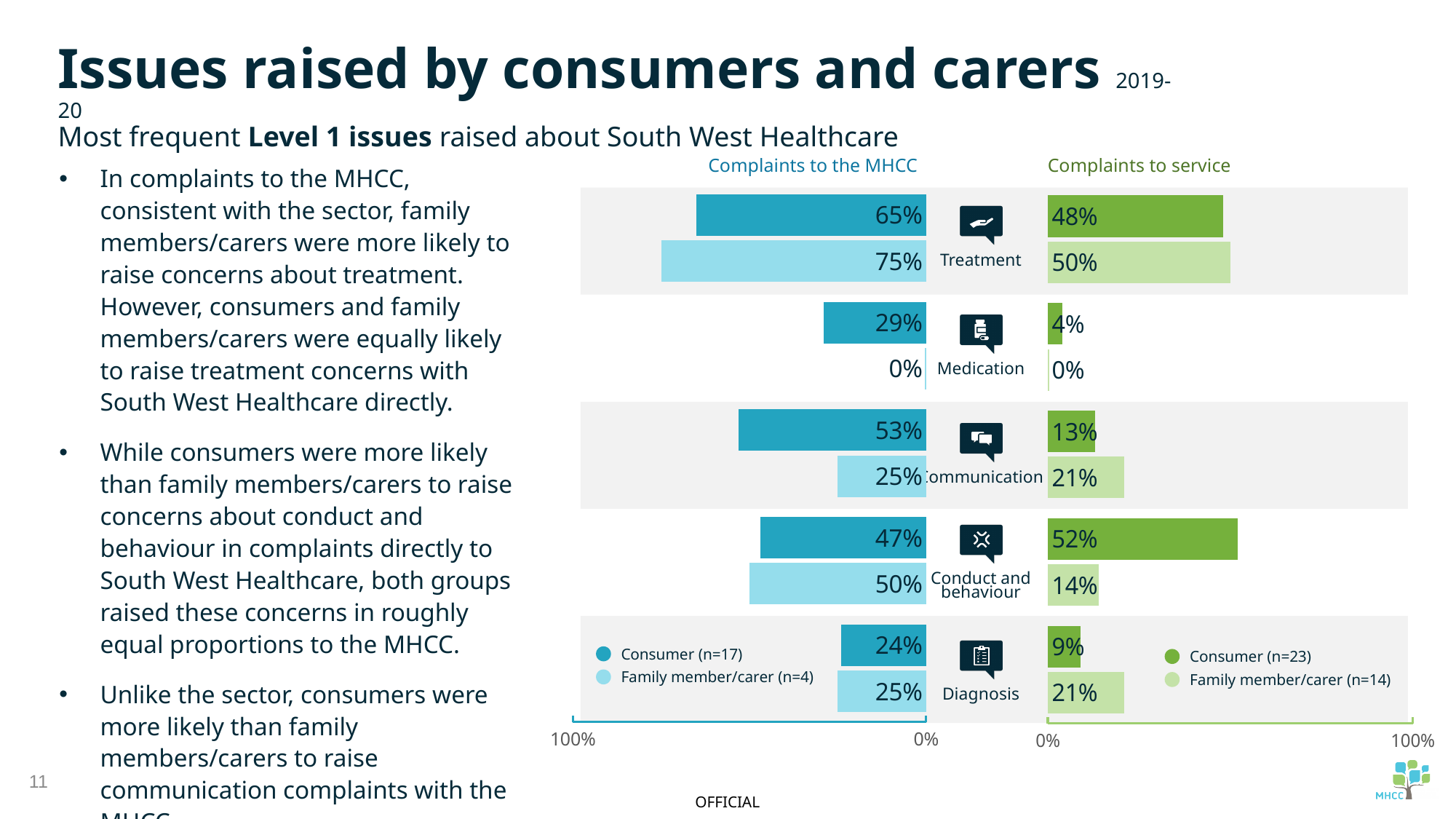
In the 'Complaints to the MHCC' chart, what is the value for Consumer for Treatment? 65% In the 'Complaints to service' chart, which category has the lowest Consumer value? Medication In the 'Complaints to service' chart, what is the value for Consumer for Conduct and behaviour? 52% In the 'Complaints to service' chart, what is the value for Family member/carer for Diagnosis? 21% In the 'Complaints to the MHCC' chart, which is larger for Treatment: the Consumer value or the Family member/carer value? Family member/carer In the 'Complaints to the MHCC' chart, which category has the highest Family member/carer value? Treatment What type of chart is the 'Complaints to service' chart? Bar chart In the 'Complaints to service' chart, what is the difference between the Consumer and Family member/carer values for Conduct and behaviour? 38% In the 'Complaints to the MHCC' chart, what is the value for Family member/carer for Communication? 25% In the 'Complaints to the MHCC' chart, what is the difference between the Consumer and Family member/carer values for Communication? 28% How many series does the legend of the 'Complaints to the MHCC' chart list? 2 How many categories are shown in the 'Complaints to service' chart? 5